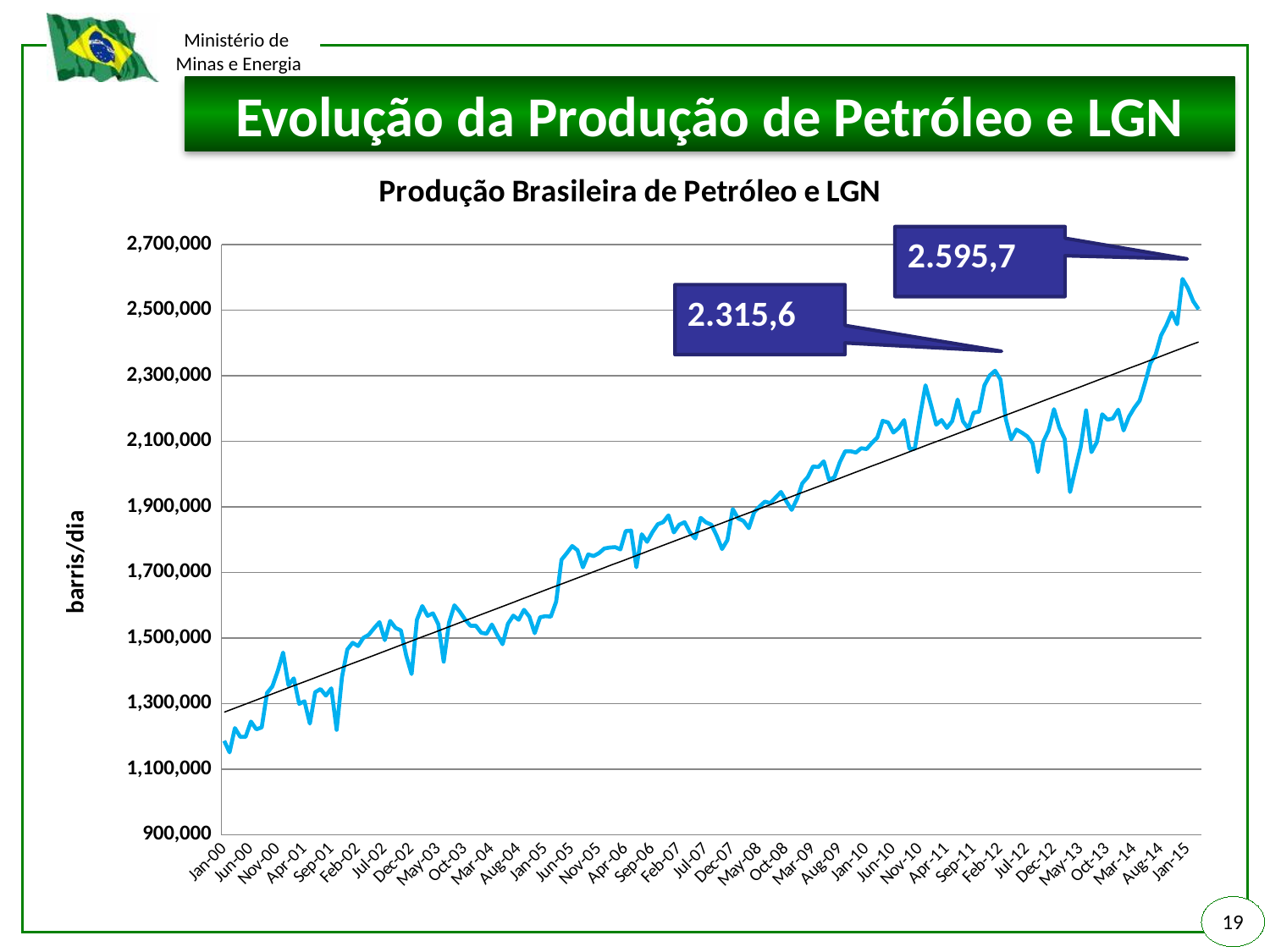
What is the title of the chart? Produção Brasileira de Petróleo e LGN Is the value for Aug-09 greater or less than 1,900,000? greater What value is shown in the callout pointing to the peak near the end of the series (late 2014)? 2.595,7 What is the difference between the two callout values, 2.595,7 and 2.315,6? 280,1 Overall, do the values rise or fall from Jan-00 to Jan-15? rise Is the value for Jan-15 greater or less than 2,300,000? greater Which of the two callout values is larger, 2.315,6 or 2.595,7? 2.595,7 Is the value at the dip near May-13 greater or less than 2,100,000? less What kind of chart is shown on the slide? line chart What is the label on the vertical axis of the chart? barris/dia What value is shown in the callout pointing to the peak near Feb-12? 2.315,6